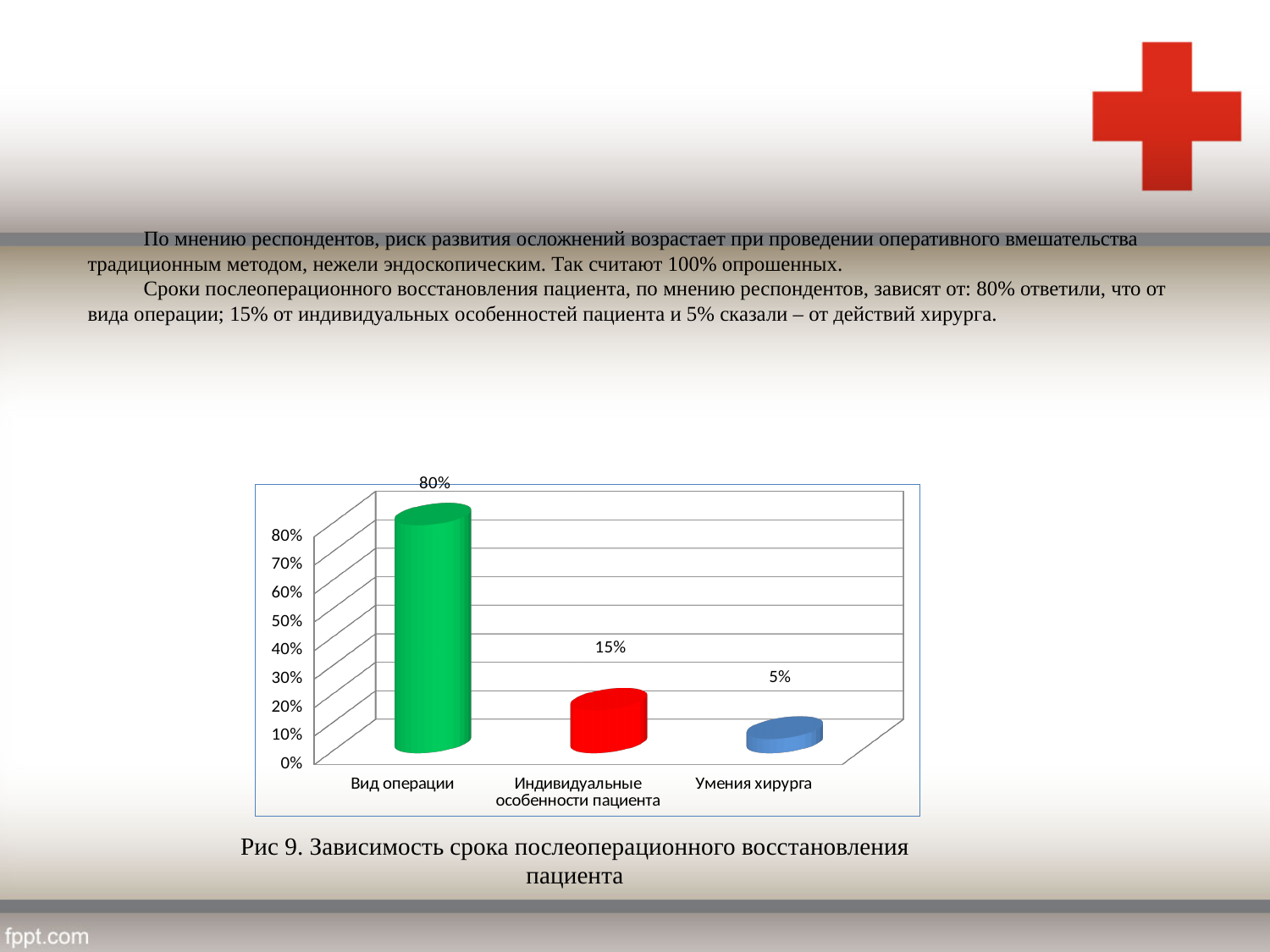
Which category has the lowest value? Умения хирурга Which category has the highest value? Вид операции What is the value for Умения хирурга? 5% Which is larger, the value for Индивидуальные особенности пациента or the value for Умения хирурга? Индивидуальные особенности пациента What is the value for Вид операции? 80% What is the difference between the values for Индивидуальные особенности пациента and Умения хирурга? 10% What is the difference between the values for Вид операции and Индивидуальные особенности пациента? 65% Is the value for Вид операции greater or less than 50%? greater What is the value for Индивидуальные особенности пациента? 15% How many categories are shown on the chart? 3 Do the values rise or fall from left to right along the x axis? fall What kind of chart is shown on the slide? bar chart